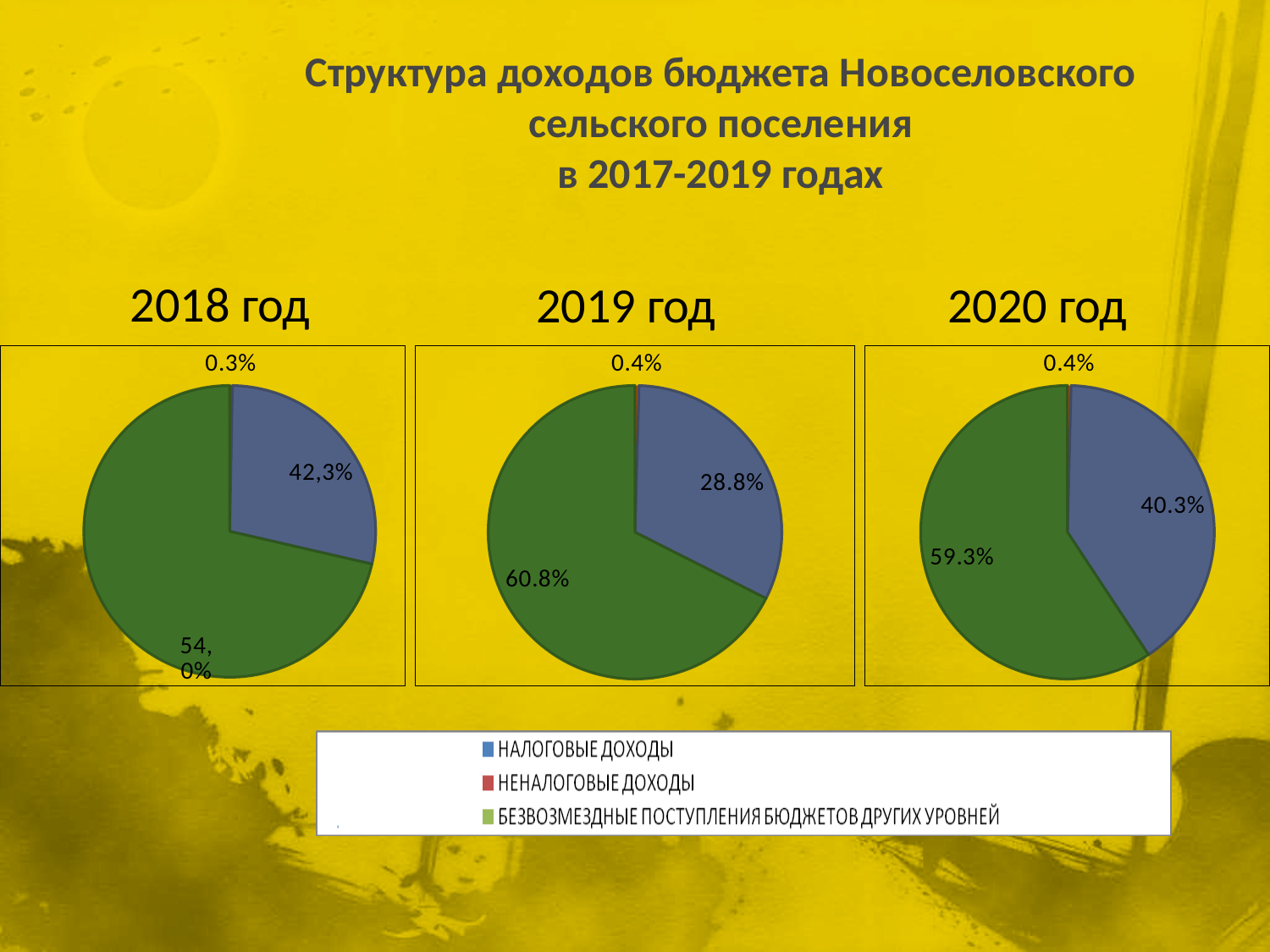
In the 2020 год chart, what share is shown for НАЛОГОВЫЕ ДОХОДЫ (blue slice)? 40.3% How many pie charts are shown on the slide? 3 What type of chart is used for the 2018 год data? Pie chart In the 2019 год chart, what share is shown for НАЛОГОВЫЕ ДОХОДЫ (blue slice)? 28.8% In the 2019 год chart, which category has the largest share? БЕЗВОЗМЕЗДНЫЕ ПОСТУПЛЕНИЯ БЮДЖЕТОВ ДРУГИХ УРОВНЕЙ In the 2020 год chart, what share is shown for БЕЗВОЗМЕЗДНЫЕ ПОСТУПЛЕНИЯ БЮДЖЕТОВ ДРУГИХ УРОВНЕЙ (green slice)? 59.3% Is the share of НАЛОГОВЫЕ ДОХОДЫ larger in the 2019 год chart or in the 2020 год chart? 2020 год In the 2020 год chart, which category has the smallest share? НЕНАЛОГОВЫЕ ДОХОДЫ In the 2018 год chart, what share is shown for НЕНАЛОГОВЫЕ ДОХОДЫ (red slice)? 0.3% Which colour represents НЕНАЛОГОВЫЕ ДОХОДЫ in the legend? Red How many categories does the legend list? 3 In the 2019 год chart, what is the difference between the shares of БЕЗВОЗМЕЗДНЫЕ ПОСТУПЛЕНИЯ БЮДЖЕТОВ ДРУГИХ УРОВНЕЙ and НАЛОГОВЫЕ ДОХОДЫ? 32.0%